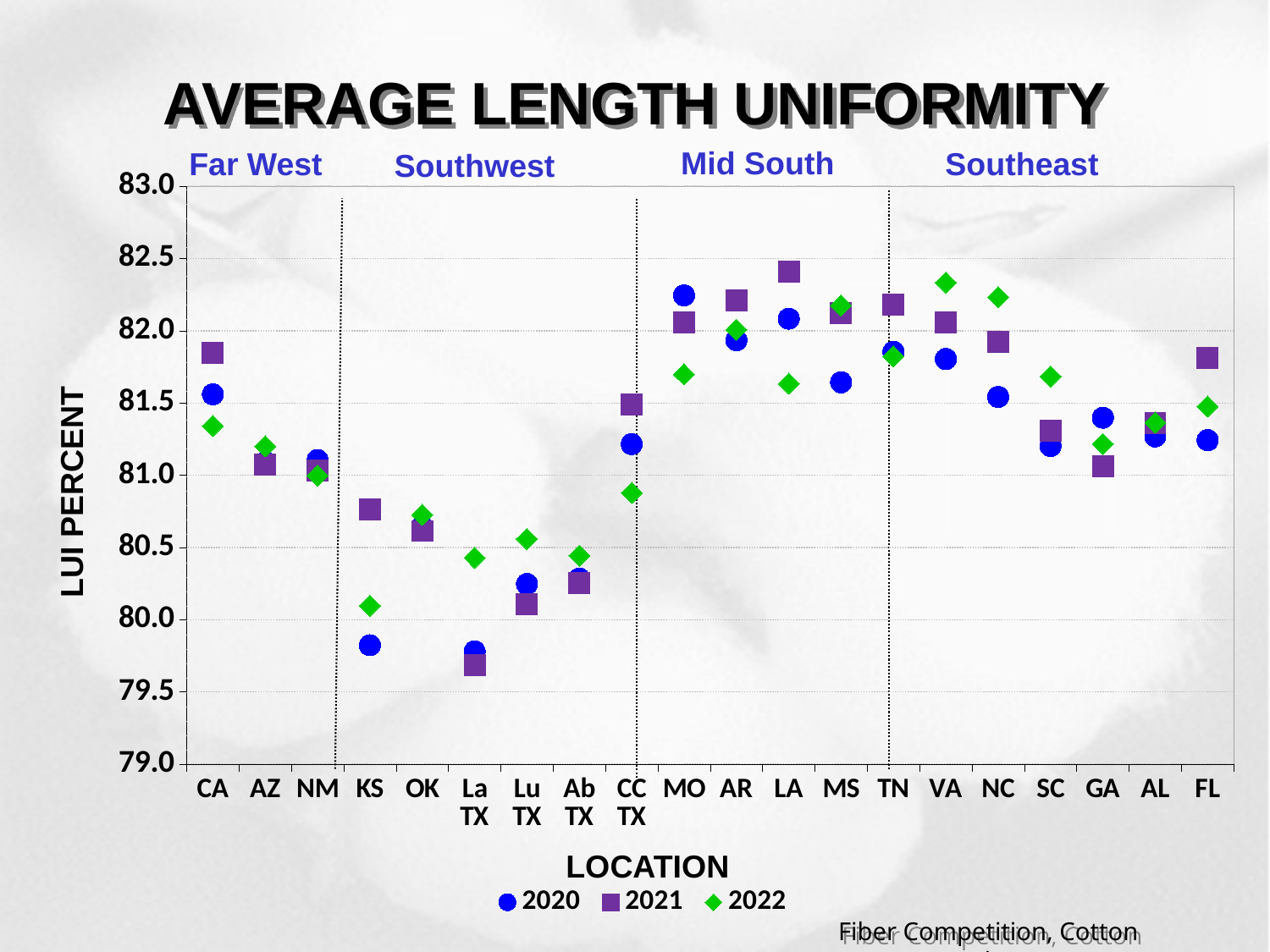
How many series does the legend list? 3 What kind of chart is shown on the slide? scatter chart Is the 2021 value for LA greater or less than 82.0? greater Which location has the lowest 2021 value? La TX Is the 2020 value for MO greater or less than 82.0? greater Which location has the highest 2021 value? LA Which is larger, the 2021 value for CA or the 2021 value for AZ? CA Is the 2022 value for CC TX greater or less than 81.0? less What is the title of the chart? AVERAGE LENGTH UNIFORMITY Do the 2021 values rise or fall from CA to NM in the Far West region? fall How many locations are plotted along the x axis? 20